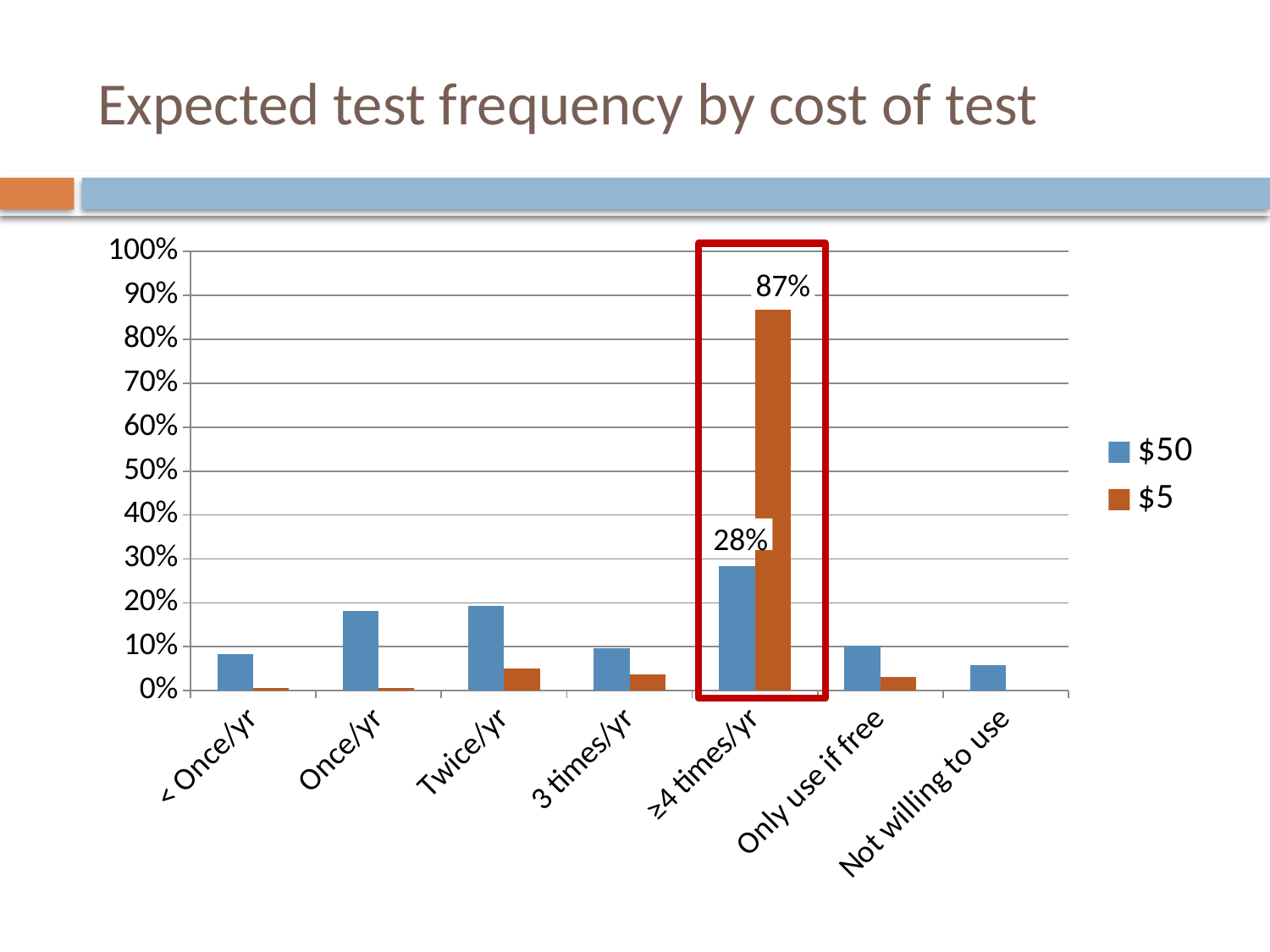
How many series does the legend list? 2 What is the difference between the $5 and $50 values at ≥4 times/yr? 59% Which category has the highest value for the $50 series? ≥4 times/yr At ≥4 times/yr, which series has the larger value, $50 or $5? $5 Is the value for the $50 series at Twice/yr greater or less than 10%? greater How many categories are shown on the x axis? 7 What type of chart is shown on the slide? Bar chart What is the value for the $5 series at ≥4 times/yr? 87% For the $50 series, which is larger, Twice/yr or 3 times/yr? Twice/yr Which category has the highest value for the $5 series? ≥4 times/yr Is the value for the $5 series at Twice/yr greater or less than 10%? less What is the value for the $50 series at ≥4 times/yr? 28%